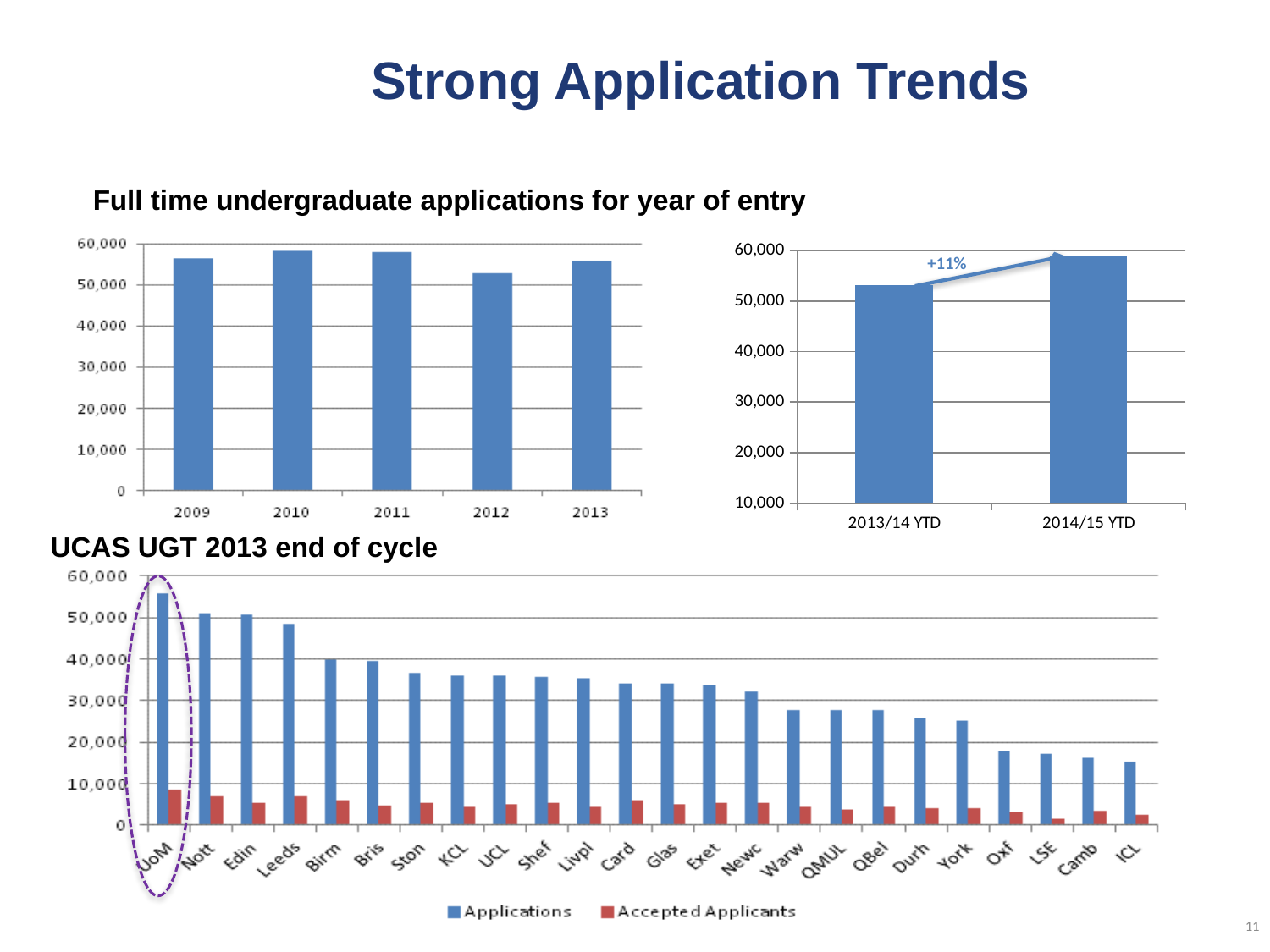
What kind of chart is the 'Full time undergraduate applications for year of entry' chart? bar chart In the 'UCAS UGT 2013 end of cycle' chart, how many series does the legend list? 2 In the 'Full time undergraduate applications for year of entry' chart, is the value for 2012 greater or less than 50,000? greater In the top-right chart, is the value for 2013/14 YTD greater or less than 50,000? greater In the 'UCAS UGT 2013 end of cycle' chart, is the Applications value for Leeds greater or less than 50,000? less In the 'UCAS UGT 2013 end of cycle' chart, which institution has the lowest number of Accepted Applicants? LSE In the 'Full time undergraduate applications for year of entry' chart, which year has the lowest value? 2012 In the 'UCAS UGT 2013 end of cycle' chart, what are the two legend entries? Applications, Accepted Applicants In the 'Full time undergraduate applications for year of entry' chart, how many years are shown on the x axis? 5 In the top-right chart comparing 2013/14 YTD and 2014/15 YTD, which of the two bars is larger? 2014/15 YTD In the 'UCAS UGT 2013 end of cycle' chart, which institution has the highest number of Applications? UoM In the top-right chart, what percentage change is annotated between 2013/14 YTD and 2014/15 YTD? +11%